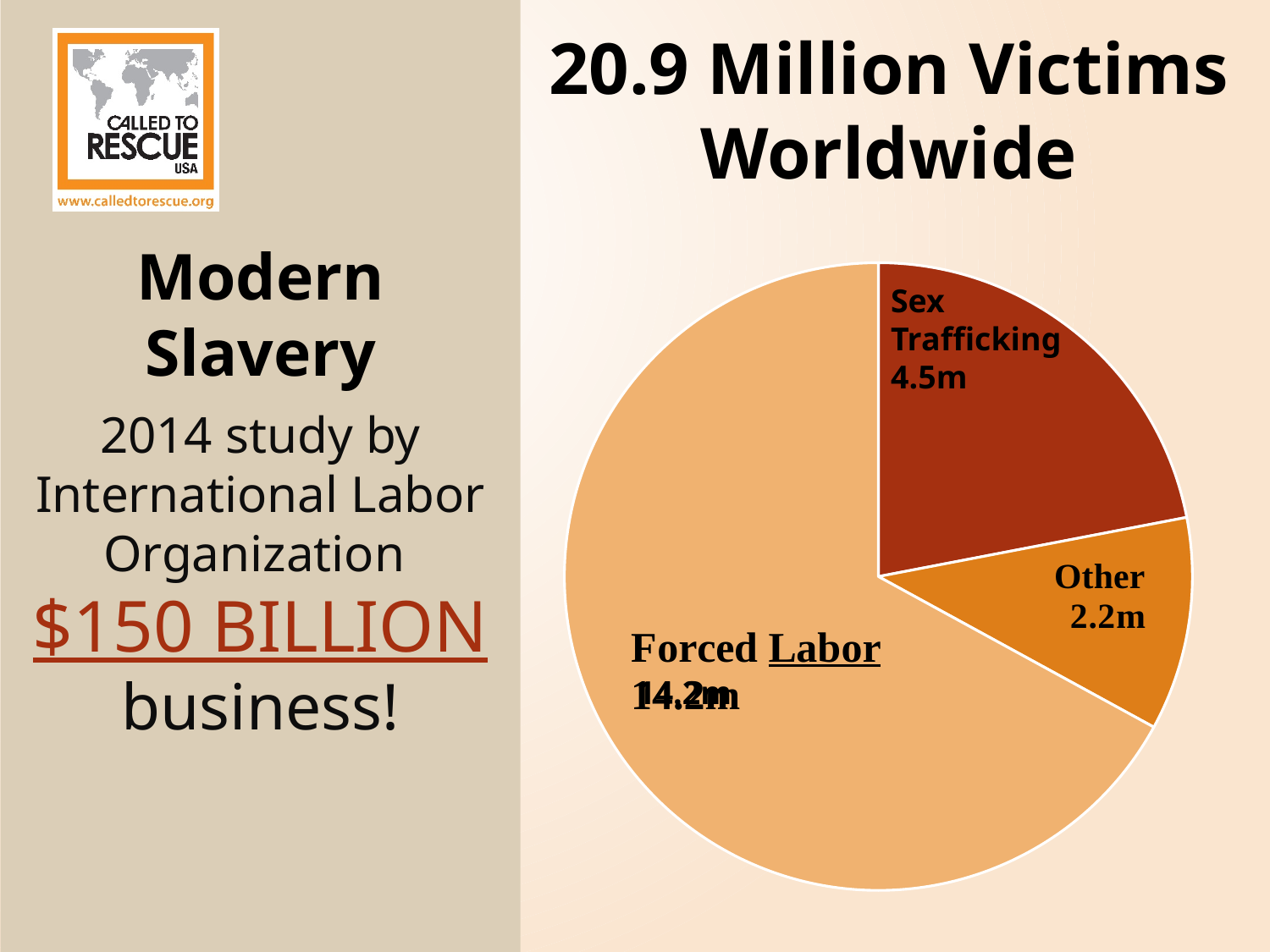
Which slice of the pie is coloured dark red? Sex Trafficking What is the title of the chart? 20.9 Million Victims Worldwide What is the value shown for Sex Trafficking? 4.5m Which is larger, Sex Trafficking or Other? Sex Trafficking Which category has the smallest slice of the pie? Other Which category has the largest slice of the pie? Forced Labor What is the difference between the Sex Trafficking value and the Other value? 2.3m What is the value shown for Other? 2.2m What kind of chart is shown on the slide? pie chart How many slices does the pie chart have? 3 Which is larger, Forced Labor or Sex Trafficking? Forced Labor